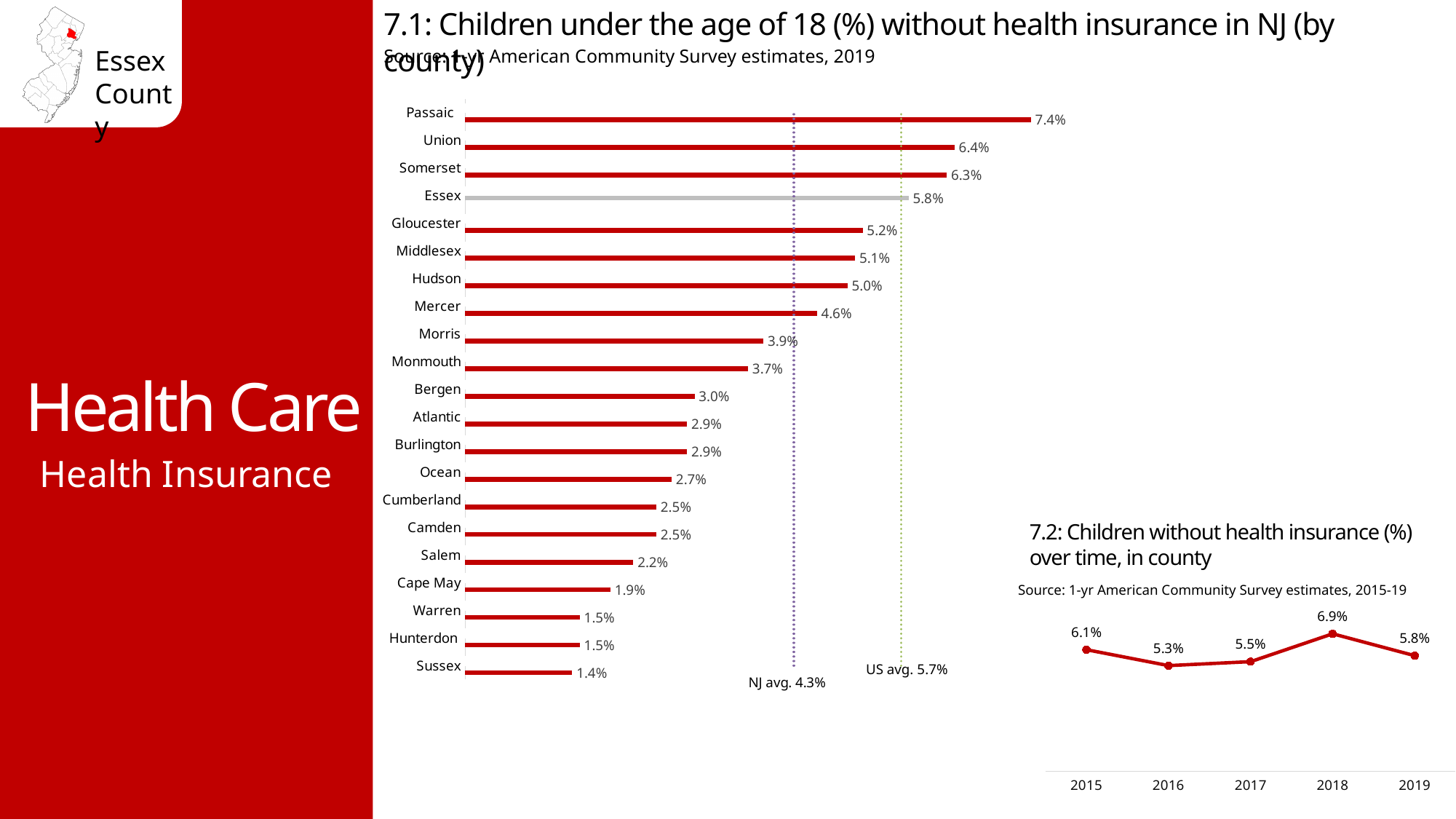
In chart 7.2, which year has the lowest value? 2016 In chart 7.2, what is the value for 2018? 6.9% In chart 7.1, which county has a larger value, Union or Somerset? Union In chart 7.1, what is the NJ average shown by the dotted line? 4.3% In chart 7.1, how many counties are shown? 21 In chart 7.1, which county has the lowest percentage of children without health insurance? Sussex In chart 7.1, what is the value for Mercer? 4.6% In chart 7.1, what is the difference between the values for Passaic and Essex? 1.6% In chart 7.1, which county has the highest percentage of children without health insurance? Passaic In chart 7.2, what is the difference between the values for 2018 and 2019? 1.1% In chart 7.1 (children under 18 without health insurance by county), what is the value for Essex? 5.8% What kind of chart is chart 7.2 (children without health insurance over time)? Line chart